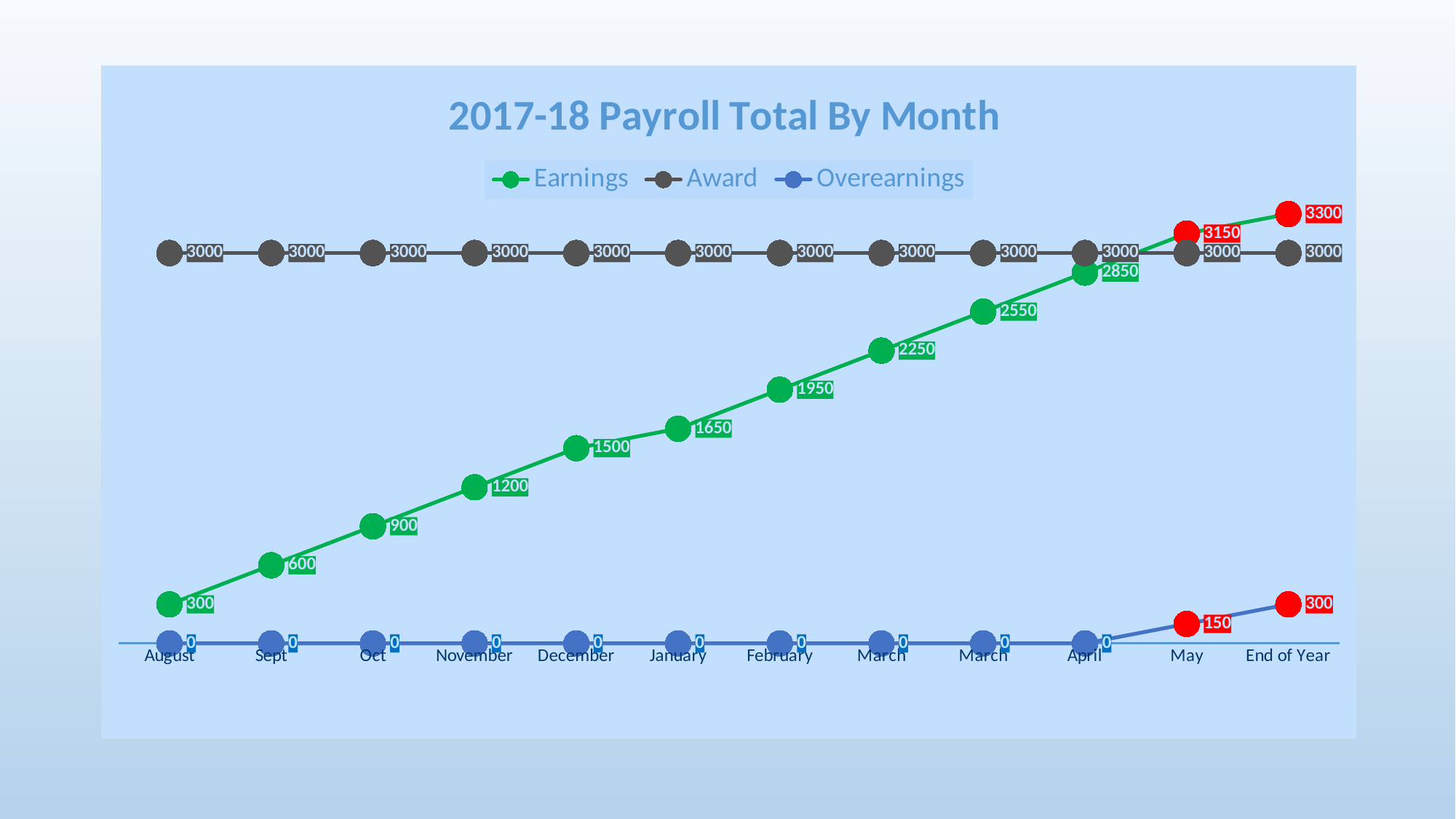
What is the Award value for January? 3000 Which is larger in April, the Earnings value or the Award value? Award How many categories are shown on the x axis? 12 What type of chart is shown on the slide? line chart Do the Earnings values rise or fall from August to End of Year? rise Which category has the lowest Earnings value? August How many series does the legend list? 3 What is the Earnings value for May? 3150 What is the Overearnings value for End of Year? 300 What is the difference between the Earnings values for End of Year and August? 3000 What is the Earnings value for December? 1500 Which category has the highest Earnings value? End of Year